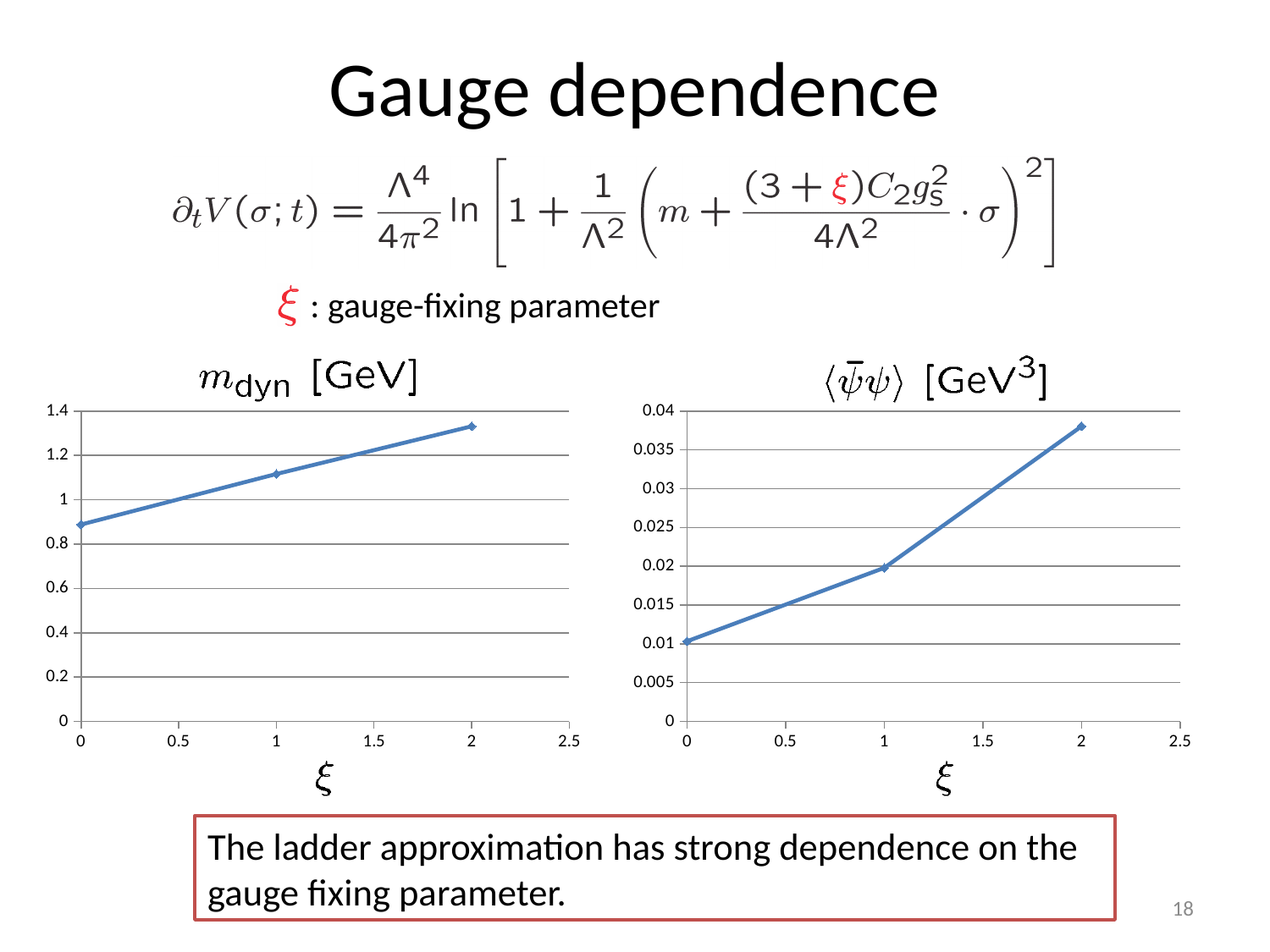
On the left chart (m_dyn [GeV]), do the values rise or fall as ξ increases? rise How many data points are plotted on the left chart (m_dyn [GeV])? 3 On the right chart (⟨ψ̄ψ⟩ [GeV³]), at which value of ξ is the plotted value lowest? 0 What kind of chart is the left chart (m_dyn [GeV])? line chart On the right chart (⟨ψ̄ψ⟩ [GeV³]), is the value at ξ = 2 greater or less than 0.035? greater What is the label on the horizontal axis of both charts? ξ On the left chart (m_dyn [GeV]), is the value at ξ = 0 greater or less than 1? less How many data points are plotted on the right chart (⟨ψ̄ψ⟩ [GeV³])? 3 On the left chart (m_dyn [GeV]), which is larger: the value at ξ = 1 or the value at ξ = 2? ξ = 2 On the right chart (⟨ψ̄ψ⟩ [GeV³]), do the values rise or fall as ξ increases? rise What kind of chart is the right chart (⟨ψ̄ψ⟩ [GeV³])? line chart On the left chart (m_dyn [GeV]), is the value at ξ = 2 greater or less than 1.2? greater